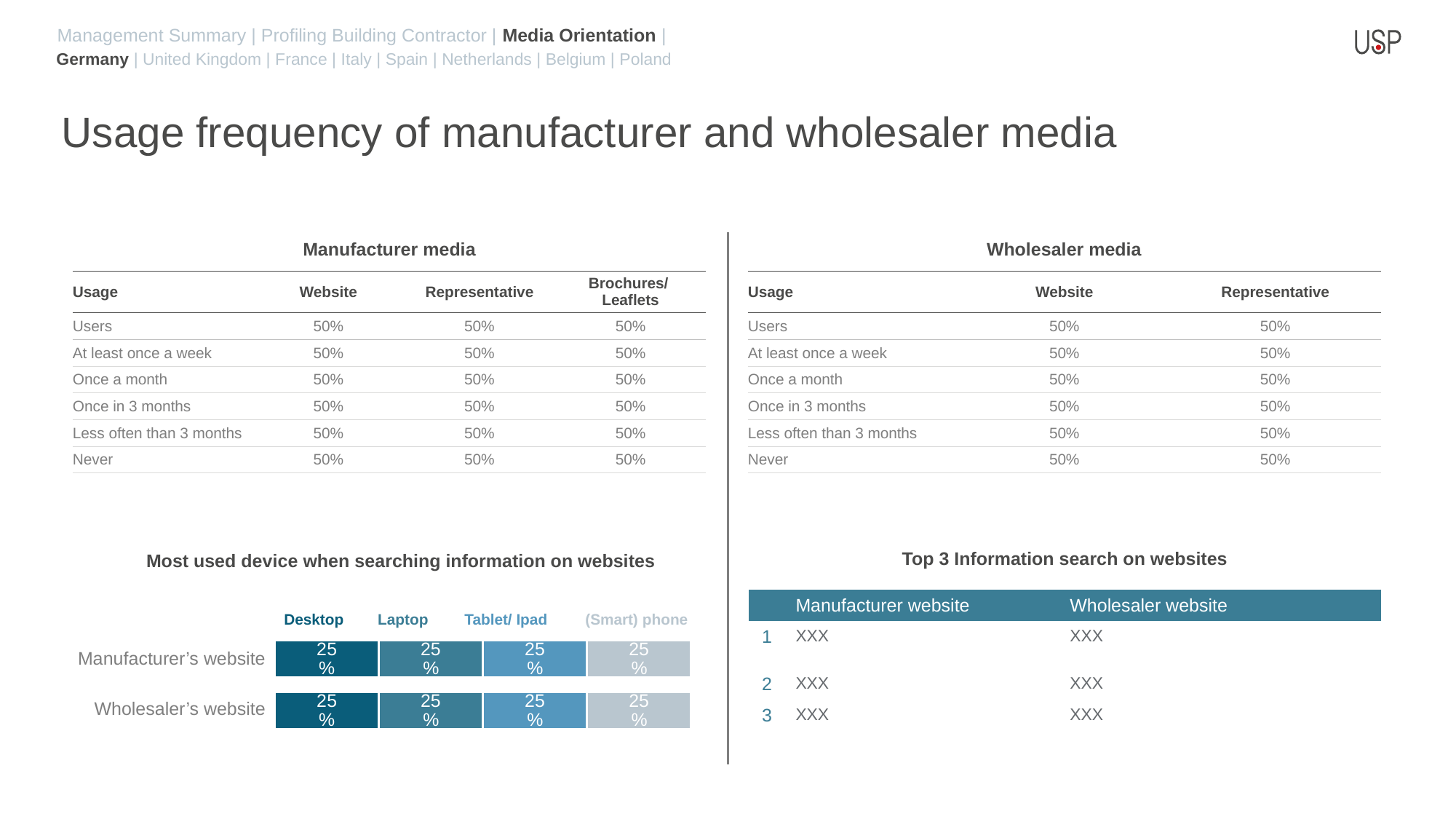
In the chart 'Most used device when searching information on websites', what is the value for Tablet/ Ipad for Manufacturer's website? 25% In the chart 'Most used device when searching information on websites', what is the value for (Smart) phone for Wholesaler's website? 25% In the chart 'Most used device when searching information on websites', what is the total of the stacked bar for Manufacturer's website? 100% In the chart 'Most used device when searching information on websites', what is the value for Desktop for Manufacturer's website? 25% In the chart 'Most used device when searching information on websites', how many categories (bars) are shown? 2 What kind of chart is 'Most used device when searching information on websites'? Stacked bar chart In the chart 'Most used device when searching information on websites', which device series is shown in light grey? (Smart) phone In the chart 'Most used device when searching information on websites', how many device series are listed in the legend? 4 In the chart 'Most used device when searching information on websites', what is the difference between the Desktop and Laptop values for Wholesaler's website? 0% In the chart 'Most used device when searching information on websites', which device series is shown in the darkest blue? Desktop In the chart 'Most used device when searching information on websites', what is the value for Laptop for Wholesaler's website? 25%